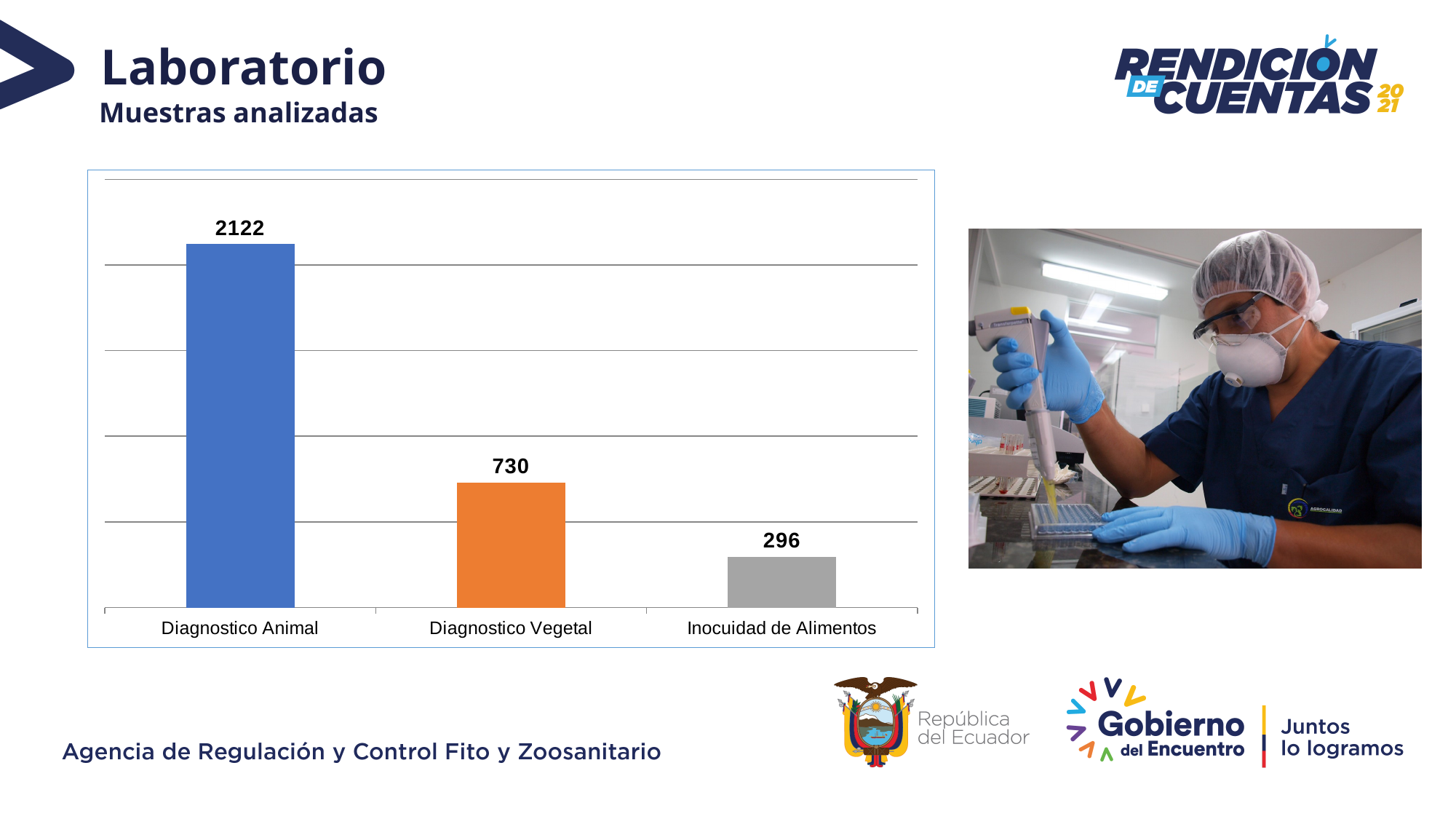
Which category has the highest value? Diagnostico Animal What is the difference between the values for Diagnostico Animal and Diagnostico Vegetal? 1392 How many categories are shown in the chart? 3 What is the value for Inocuidad de Alimentos? 296 Which category has the lowest value? Inocuidad de Alimentos Do the values rise or fall from left to right across the categories? Fall What colour is the bar for Diagnostico Vegetal? Orange Which is larger, the value for Diagnostico Vegetal or the value for Inocuidad de Alimentos? Diagnostico Vegetal What is the value for Diagnostico Animal? 2122 What is the value for Diagnostico Vegetal? 730 What kind of chart is shown on the slide? Bar chart What is the difference between the values for Diagnostico Vegetal and Inocuidad de Alimentos? 434